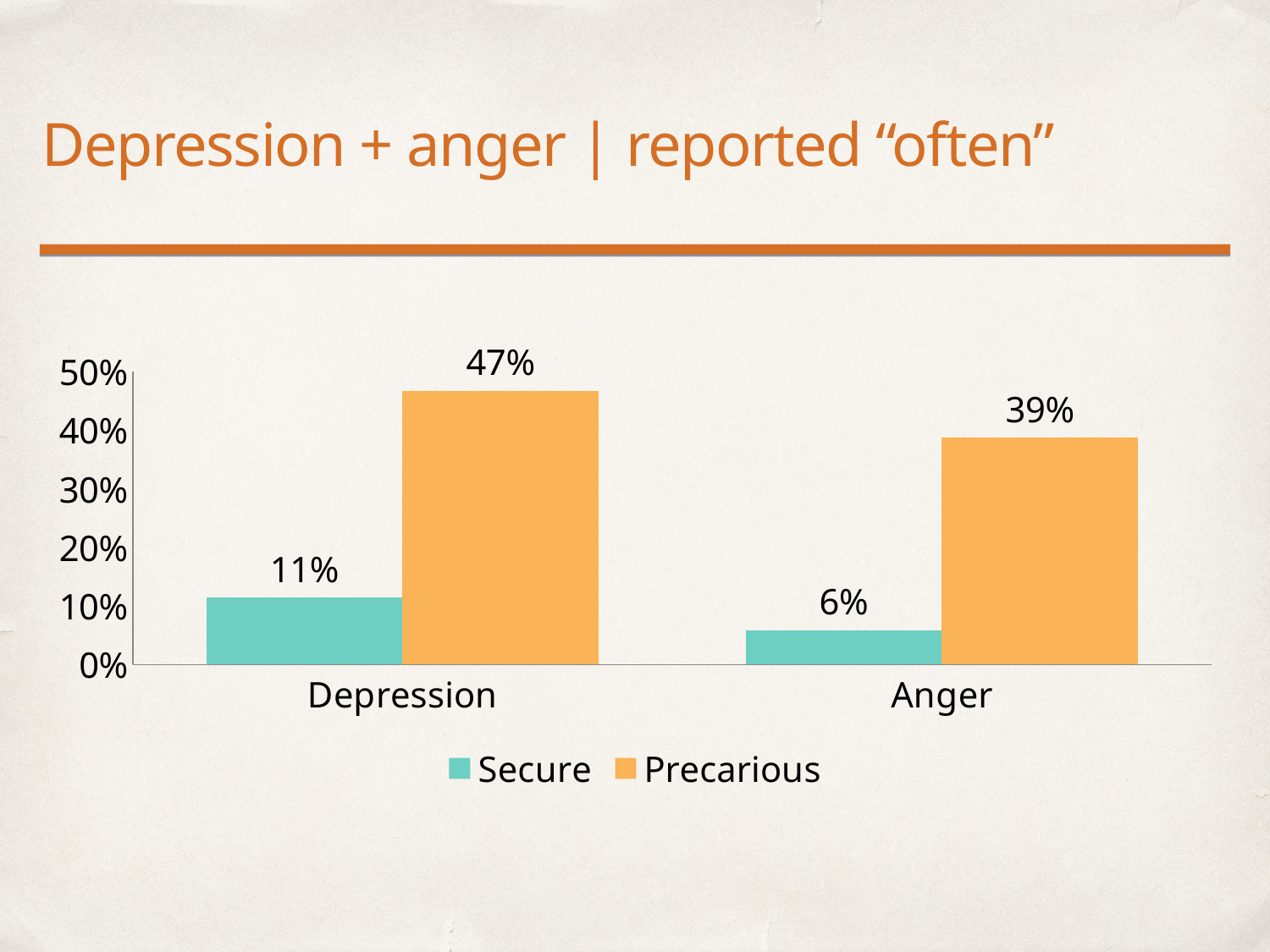
Which bar has the highest value on the chart? Precarious, Depression Which is larger: the Secure value for Depression or the Secure value for Anger? Depression Which bar has the lowest value on the chart? Secure, Anger What is the value for Precarious in the Anger category? 39% What kind of chart is shown on the slide? Bar chart What is the difference between the Precarious values for Depression and Anger? 8% What is the value for Precarious in the Depression category? 47% What is the value for Secure in the Depression category? 11% What is the value for Secure in the Anger category? 6% How many categories are shown on the x axis? 2 How many series does the legend list? 2 What is the difference between the Precarious and Secure values for Depression? 36%